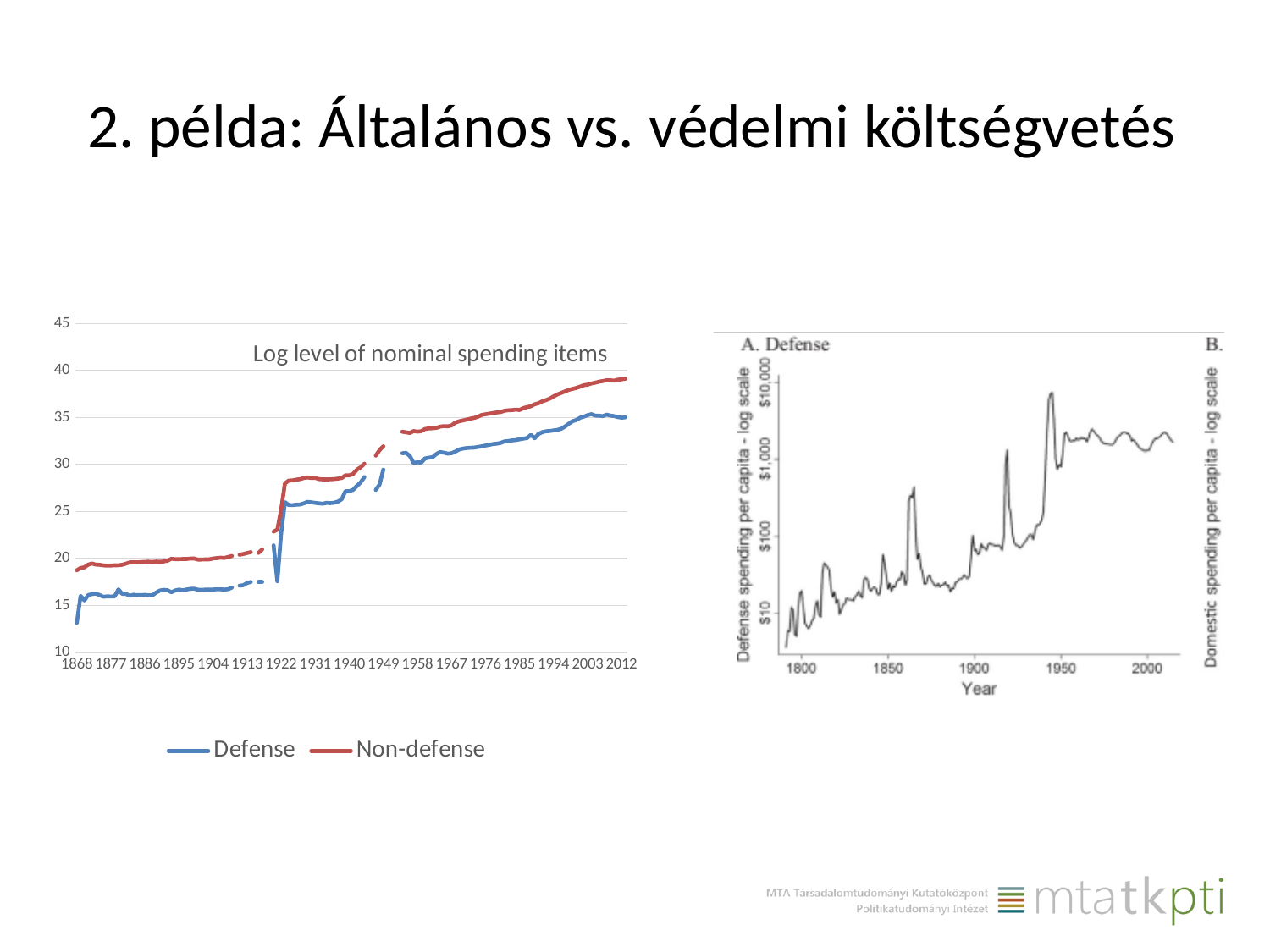
What is the x-axis label of the right chart 'A. Defense'? Year What colour is the Defense line in the left chart 'Log level of nominal spending items'? blue In the left chart 'Log level of nominal spending items', which series is higher in 2012, Defense or Non-defense? Non-defense In the left chart 'Log level of nominal spending items', is the Defense value in 2012 greater or less than 30? greater In the left chart 'Log level of nominal spending items', is the Defense value in 1868 greater or less than 15? less In the left chart 'Log level of nominal spending items', do the Non-defense values generally rise or fall from 1868 to 2012? rise In the left chart 'Log level of nominal spending items', is the Non-defense value in 1868 greater or less than 15? greater How many series does the legend of the left chart 'Log level of nominal spending items' list? 2 In the left chart 'Log level of nominal spending items', which series is higher in 1868, Defense or Non-defense? Non-defense What kind of chart is the left chart titled 'Log level of nominal spending items'? line chart